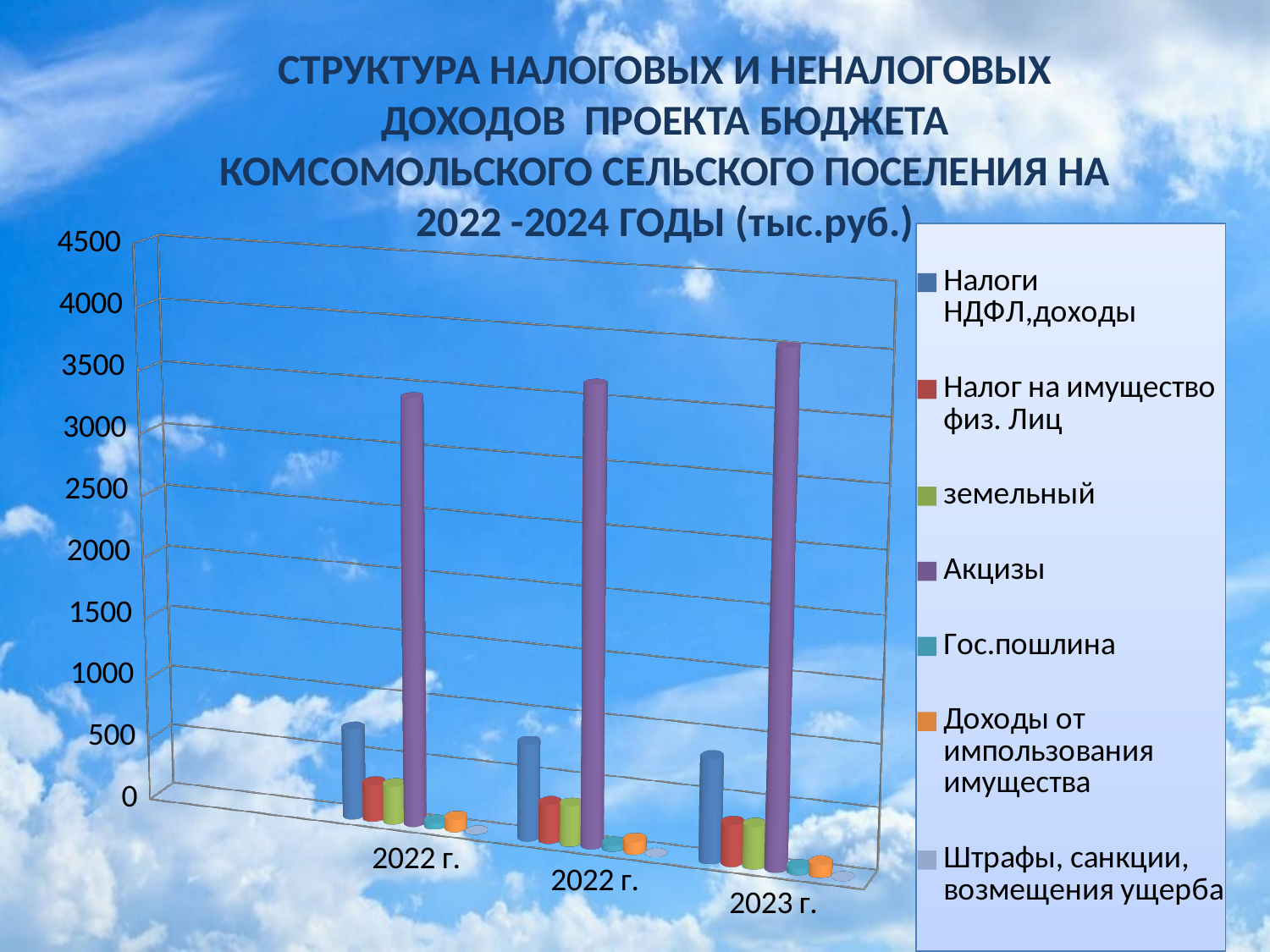
What colour are the bars for Акцизы? purple Is the value for Акцизы in the first 2022 г. category greater or less than 2500? greater How many series does the legend list? 7 How many categories are shown along the x axis? 3 What kind of chart is shown on the slide? bar chart Is the value for Акцизы in 2023 г. greater or less than 3000? greater Do the values for Акцизы rise or fall from left to right along the x axis? rise What is the highest value shown on the vertical axis? 4500 Which series has the tallest bar in the 2023 г. category? Акцизы Is the value for Налоги НДФЛ,доходы in 2023 г. greater or less than 1000? less Which series has the smallest bars across all categories? Штрафы, санкции, возмещения ущерба In 2023 г., which is larger: Акцизы or Налоги НДФЛ,доходы? Акцизы